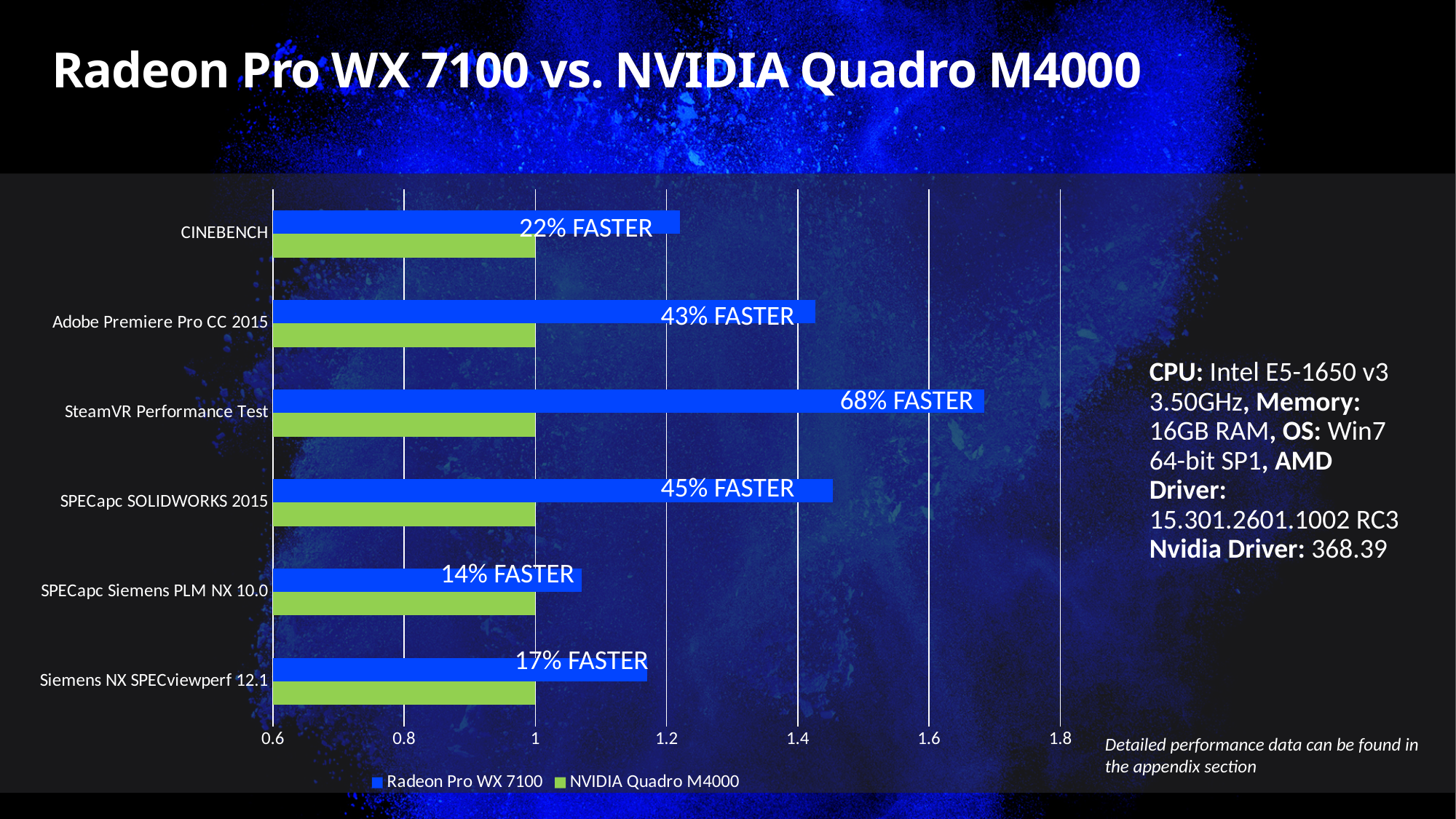
How many series does the legend list? 2 Is the Radeon Pro WX 7100 value for SPECapc SOLIDWORKS 2015 greater or less than 1.4? greater Is the Radeon Pro WX 7100 value for Siemens NX SPECviewperf 12.1 greater or less than 1.2? less How many benchmark categories are shown on the chart? 6 What is the value of the NVIDIA Quadro M4000 bar for Adobe Premiere Pro CC 2015? 1 What kind of chart is shown on the slide? bar chart For which benchmark is the Radeon Pro WX 7100 bar the longest? SteamVR Performance Test What label is printed on the Radeon Pro WX 7100 bar for SteamVR Performance Test? 68% FASTER What label is printed on the Radeon Pro WX 7100 bar for SPECapc Siemens PLM NX 10.0? 14% FASTER What label is printed on the Radeon Pro WX 7100 bar for CINEBENCH? 22% FASTER For which benchmark is the Radeon Pro WX 7100 bar the shortest? SPECapc Siemens PLM NX 10.0 Which series is shown in green in the legend? NVIDIA Quadro M4000